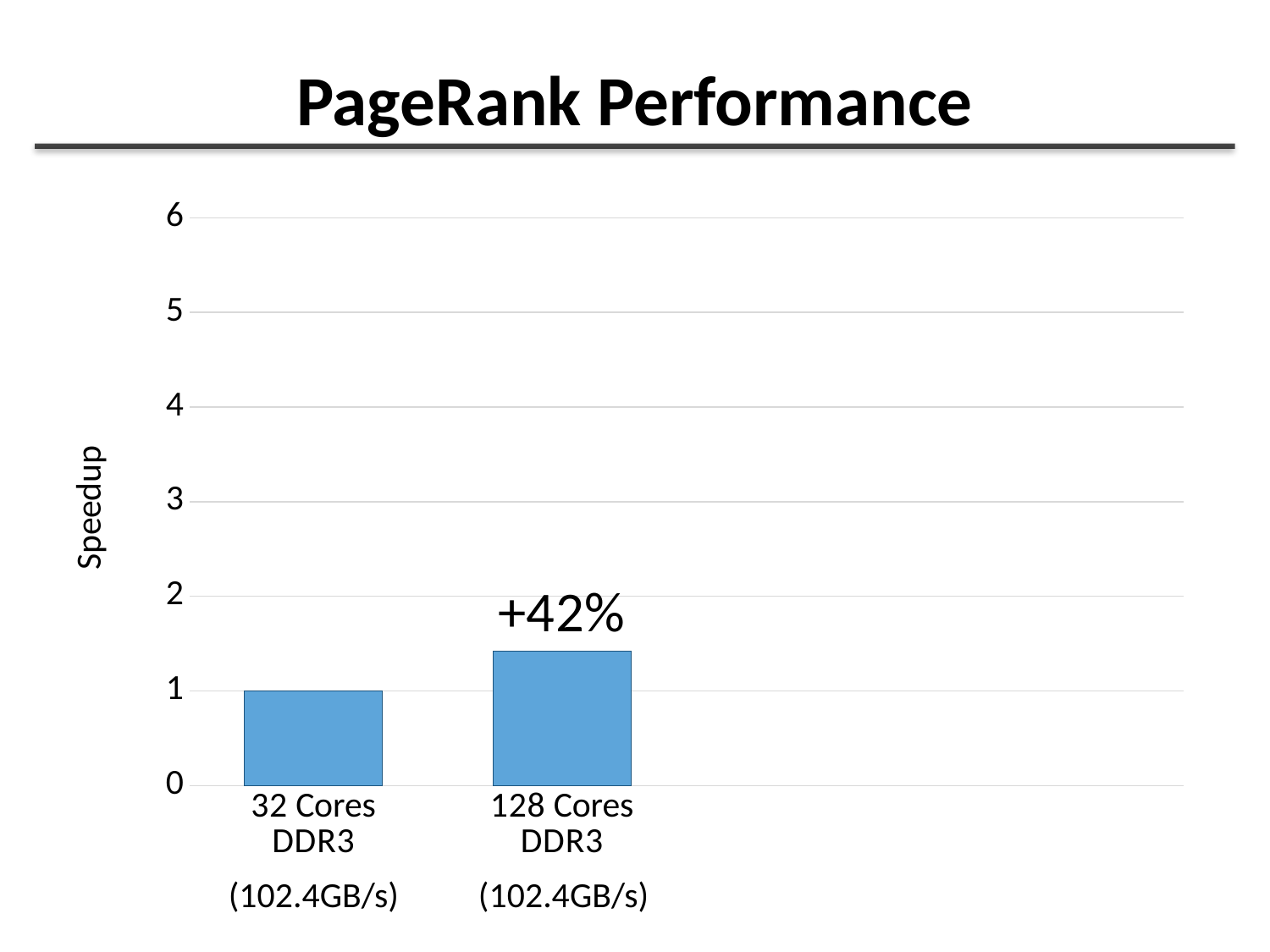
Do the speedup values rise or fall from left to right along the x axis? rise What is the speedup value for 32 Cores DDR3? 1 How many bars are plotted in the chart? 2 What kind of chart is shown on the slide? bar chart What percentage improvement is annotated above the 128 Cores DDR3 bar? +42% Is the speedup for 128 Cores DDR3 greater or less than 1? greater Which configuration has the lowest speedup? 32 Cores DDR3 What is the title of the chart? PageRank Performance Is the speedup for 128 Cores DDR3 greater or less than 2? less Which has a larger speedup, 32 Cores DDR3 or 128 Cores DDR3? 128 Cores DDR3 Which configuration has the highest speedup? 128 Cores DDR3